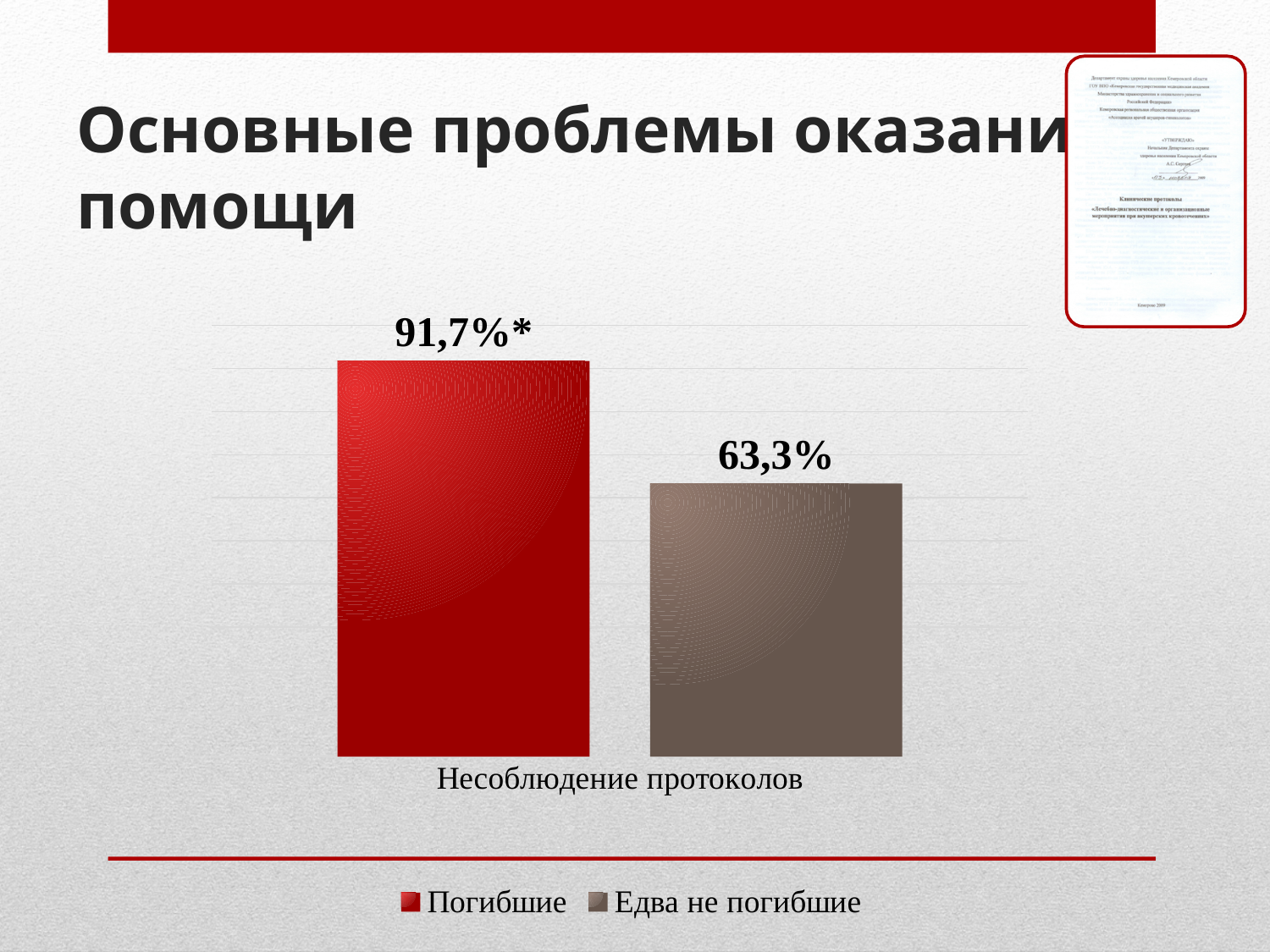
How many series does the legend list? 2 Is the value for Погибшие larger or smaller than the value for Едва не погибшие? larger What is the label of the category on the x axis? Несоблюдение протоколов Which series has the higher value for Несоблюдение протоколов? Погибшие What is the value for the Погибшие series in the Несоблюдение протоколов category? 91,7%* How many categories are shown on the x axis? 1 Which series has the lower value for Несоблюдение протоколов? Едва не погибшие Which series is shown in red in the legend? Погибшие What is the difference between the Погибшие value (91,7%) and the Едва не погибшие value (63,3%)? 28,4% What kind of chart is shown on the slide? bar chart What is the value for the Едва не погибшие series in the Несоблюдение протоколов category? 63,3%